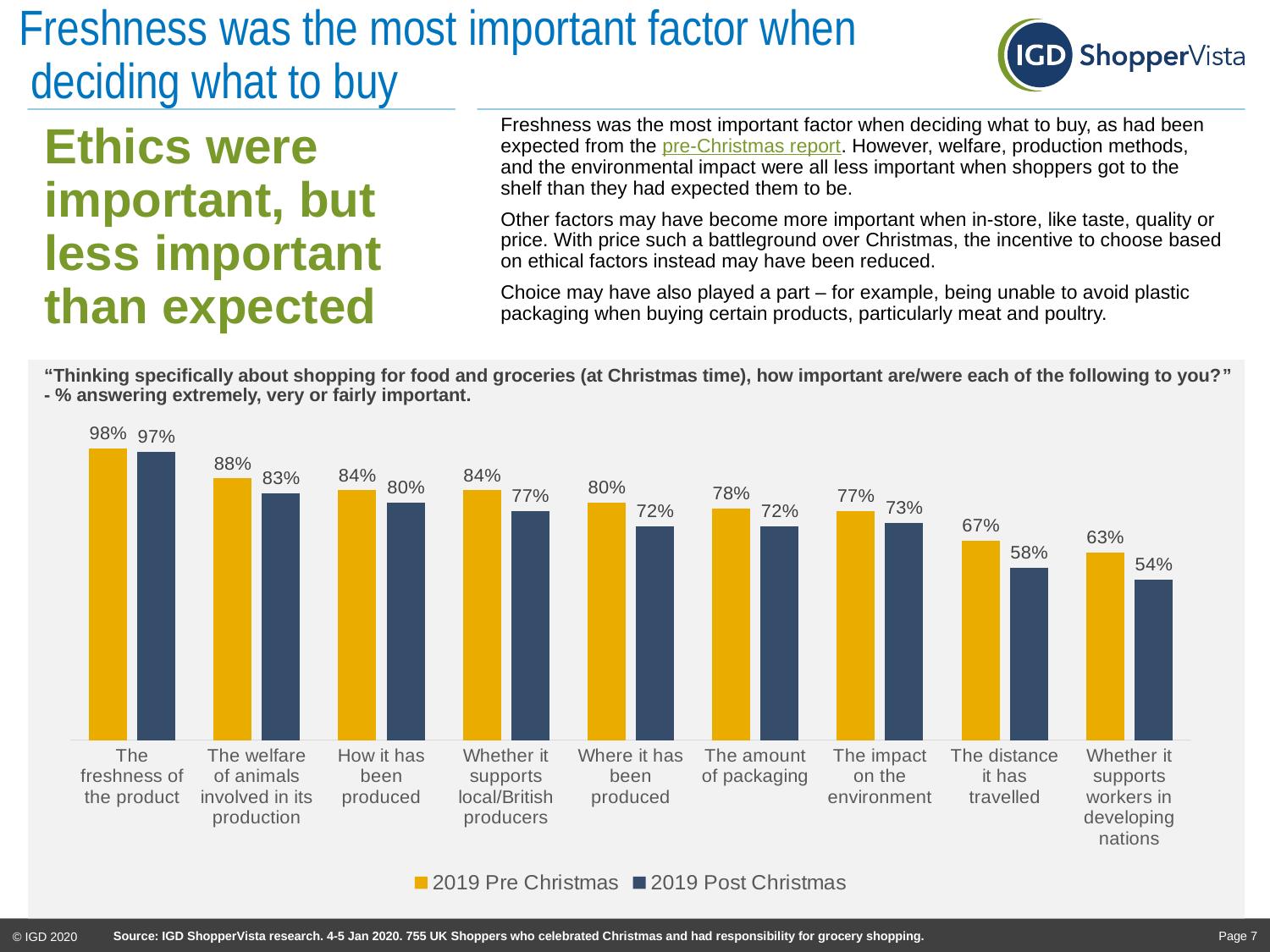
What is the 2019 Post Christmas value for 'The amount of packaging'? 72% Which category has the lowest 2019 Pre Christmas value? Whether it supports workers in developing nations What is the 2019 Pre Christmas value for 'The freshness of the product'? 98% Which colour represents the 2019 Post Christmas series in the chart? Dark blue Which is larger for 'The welfare of animals involved in its production': the 2019 Pre Christmas value or the 2019 Post Christmas value? 2019 Pre Christmas Do the 2019 Pre Christmas values rise or fall moving from left to right along the x axis? Fall How many series does the legend list? 2 How many categories are shown on the x axis of the chart? 9 What is the difference between the 2019 Pre Christmas and 2019 Post Christmas values for 'The distance it has travelled'? 9 percentage points What is the 2019 Post Christmas value for 'Whether it supports workers in developing nations'? 54% What kind of chart is shown on the slide? Bar chart Which category has the highest 2019 Post Christmas value? The freshness of the product